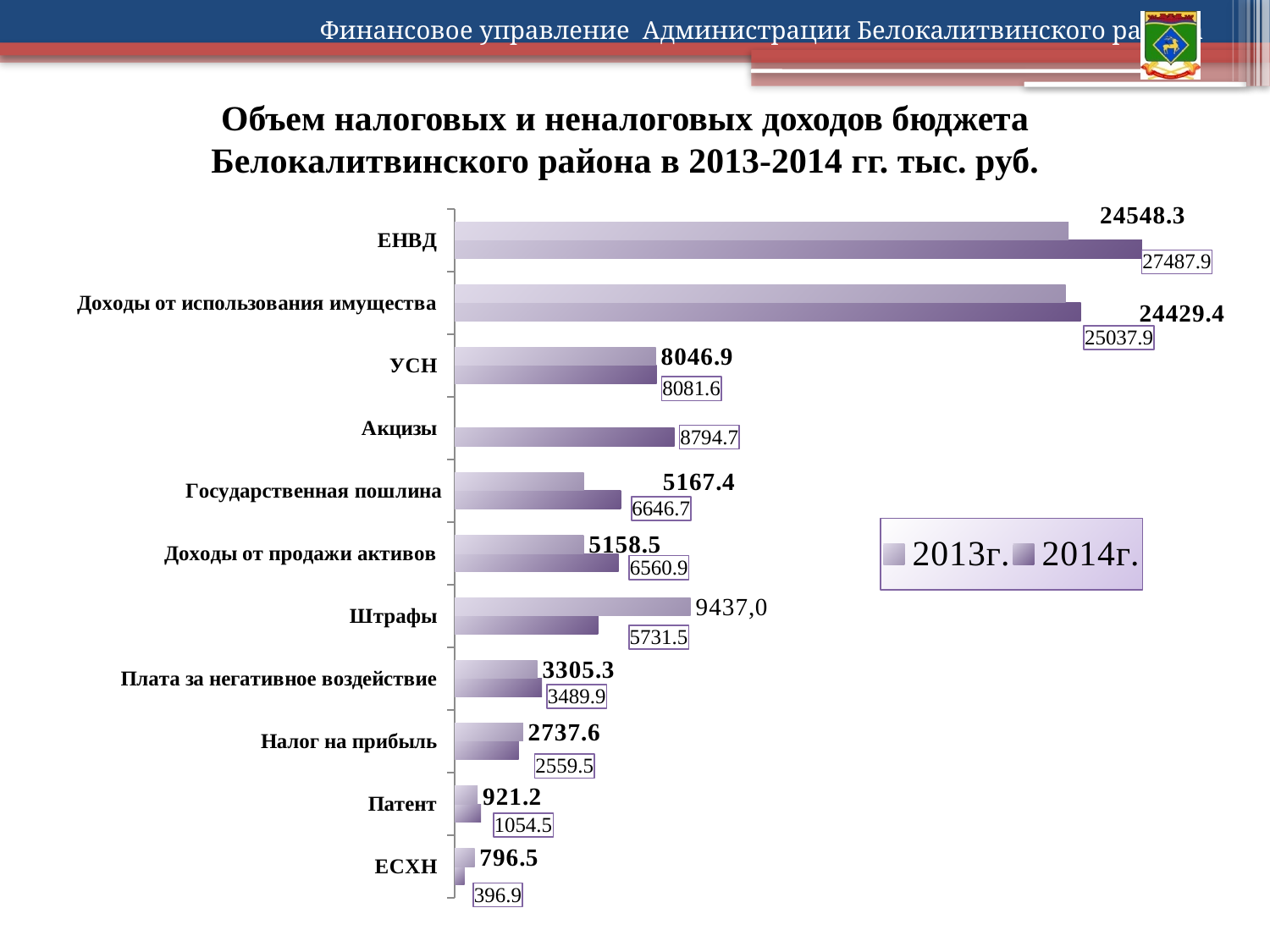
What is the 2013г. value for Патент? 921.2 What is the difference between the 2014г. and 2013г. values for ЕНВД? 2939.6 Which category has the lowest 2014г. value? ЕСХН How many series does the legend list? 2 How many categories are shown on the chart? 11 What is the 2014г. value for Акцизы? 8794.7 What is the 2013г. value for Штрафы? 9437,0 What is the difference between the 2013г. and 2014г. values for Штрафы? 3705.5 Which is larger for Налог на прибыль, the 2013г. value or the 2014г. value? 2013г. Which category has the highest 2014г. value? ЕНВД What is the 2014г. value for ЕНВД? 27487.9 What kind of chart is shown on the slide? bar chart